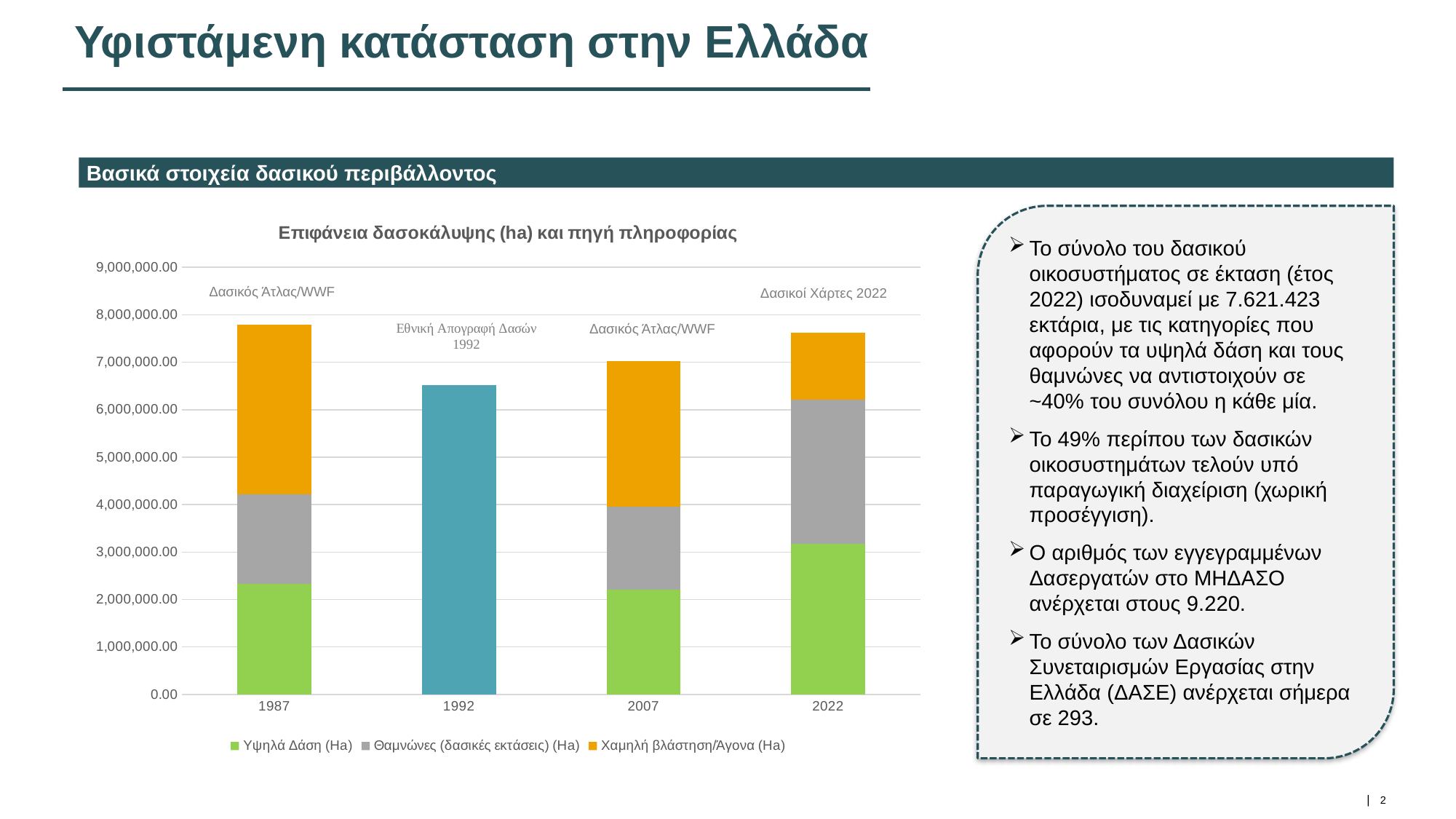
Is the total bar for 2022 greater or less than 7,000,000.00? greater How many years (categories) are shown on the x axis of the chart? 4 What source label is written above the 1992 bar? Εθνική Απογραφή Δασών 1992 Which year has the lowest total bar in the chart? 1992 Which year has the larger Υψηλά Δάση (Ha) segment, 1987 or 2022? 2022 Is the total bar for 2007 greater or less than 6,000,000.00? greater How many series does the chart legend list? 3 What is the title of the chart? Επιφάνεια δασοκάλυψης (ha) και πηγή πληροφορίας Is the total bar for 1992 greater or less than 7,000,000.00? less What kind of chart is shown on the slide? bar chart